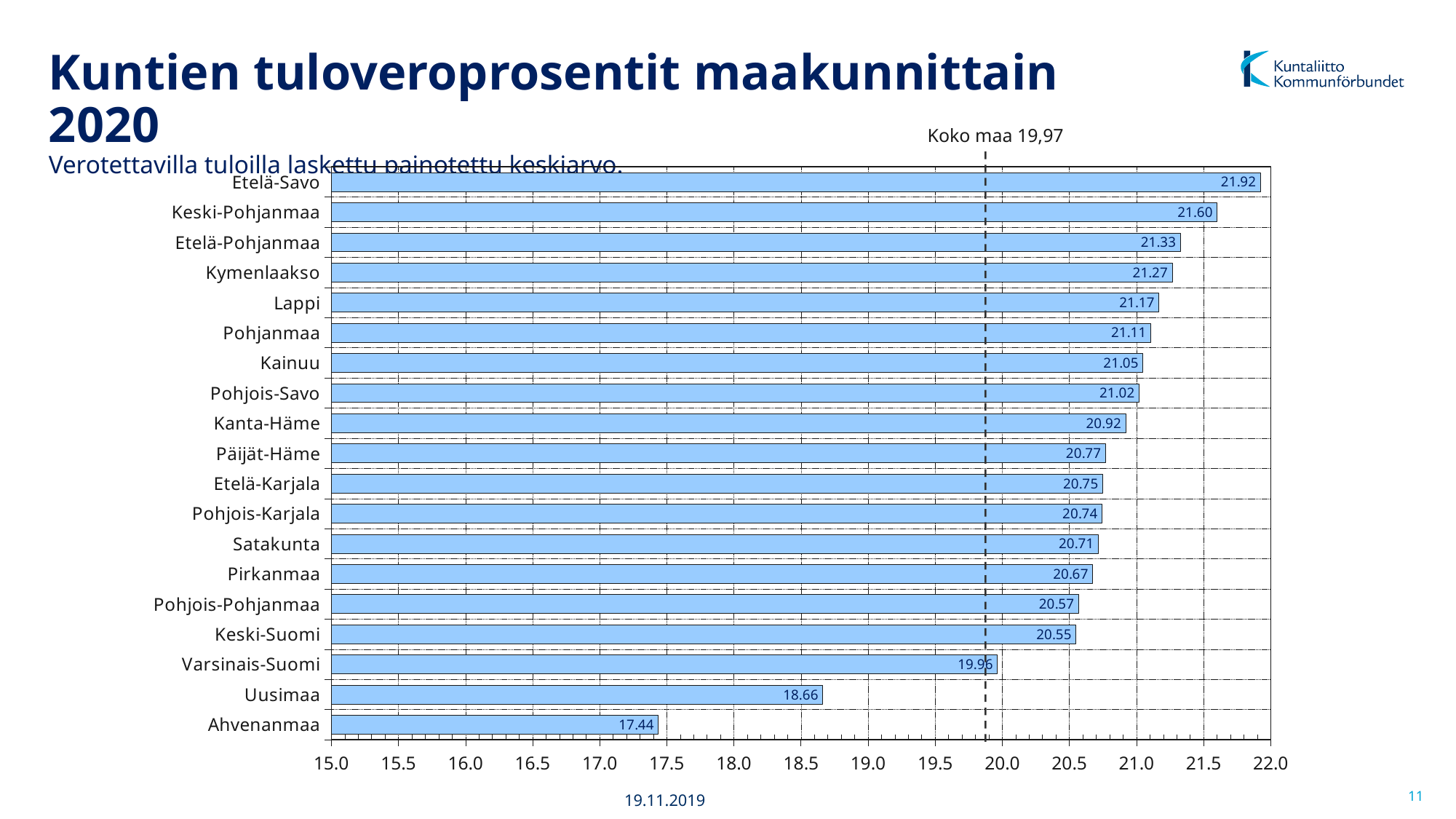
What is the value for Etelä-Savo? 21.92 What is the difference between the values for Uusimaa and Ahvenanmaa? 1.22 What is the difference between the values for Etelä-Savo and Ahvenanmaa? 4.48 Which region has the lowest value? Ahvenanmaa What is the value for Uusimaa? 18.66 What kind of chart is shown on the slide? bar chart Is the value for Uusimaa greater or less than 19.0? less Which region has the highest value? Etelä-Savo Which is larger, the value for Kymenlaakso or the value for Kainuu? Kymenlaakso How many regions are shown in the chart? 19 What is the value for Pirkanmaa? 20.67 What is the value for Lappi? 21.17